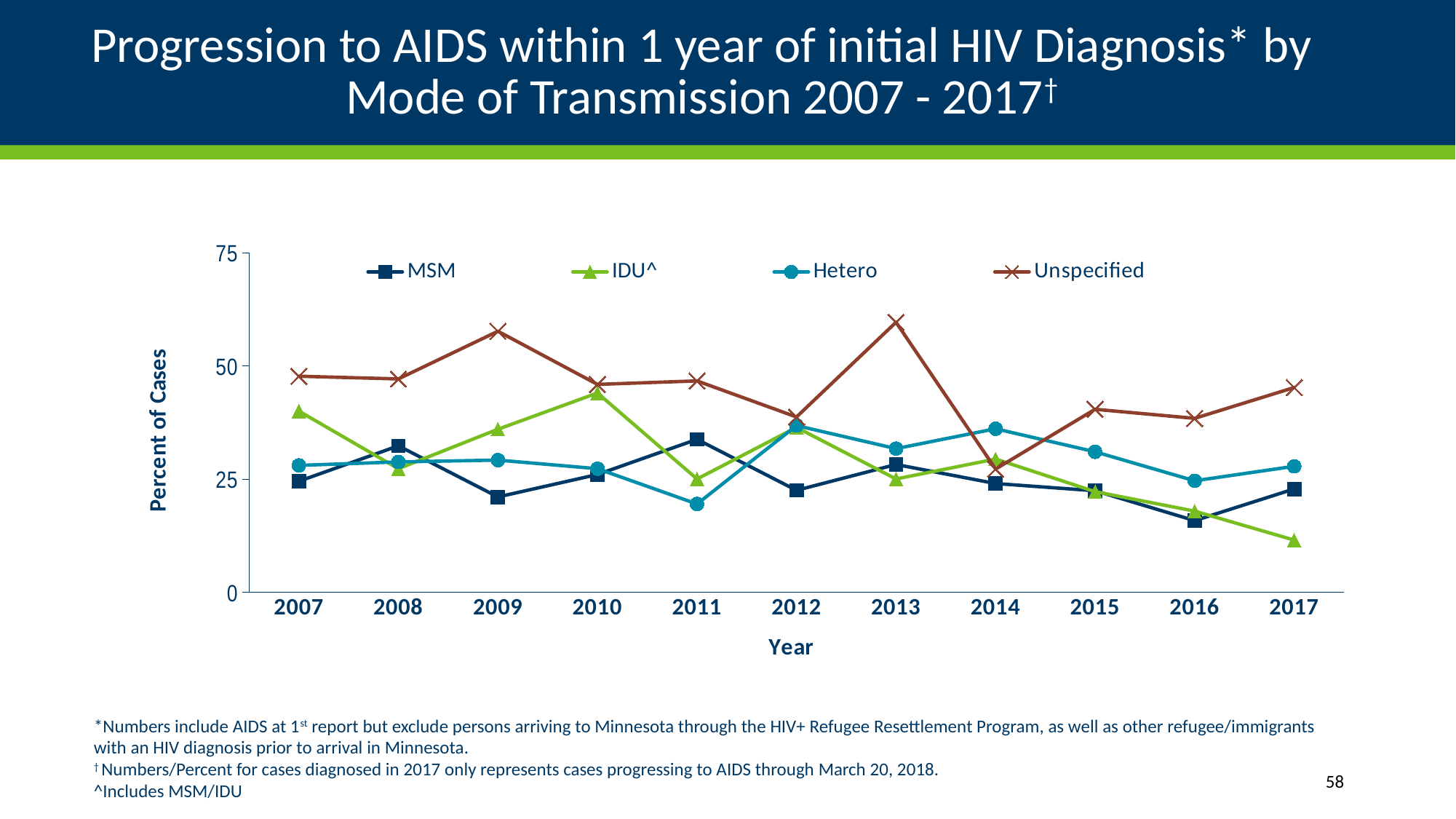
Is the value for Hetero in 2011 greater or less than 25? less How many years are plotted along the x axis? 11 What kind of chart is shown on the slide? line chart What is the label on the vertical axis? Percent of Cases Is the value for MSM in 2011 greater or less than 25? greater Which is larger for MSM: the value in 2016 or the value in 2017? 2017 Which series has the lowest value in 2017? IDU^ Which series has the highest value in 2013? Unspecified How many series does the legend list? 4 Is the value for IDU^ in 2017 greater or less than 25? less Does the IDU^ line rise or fall from 2014 to 2017? fall